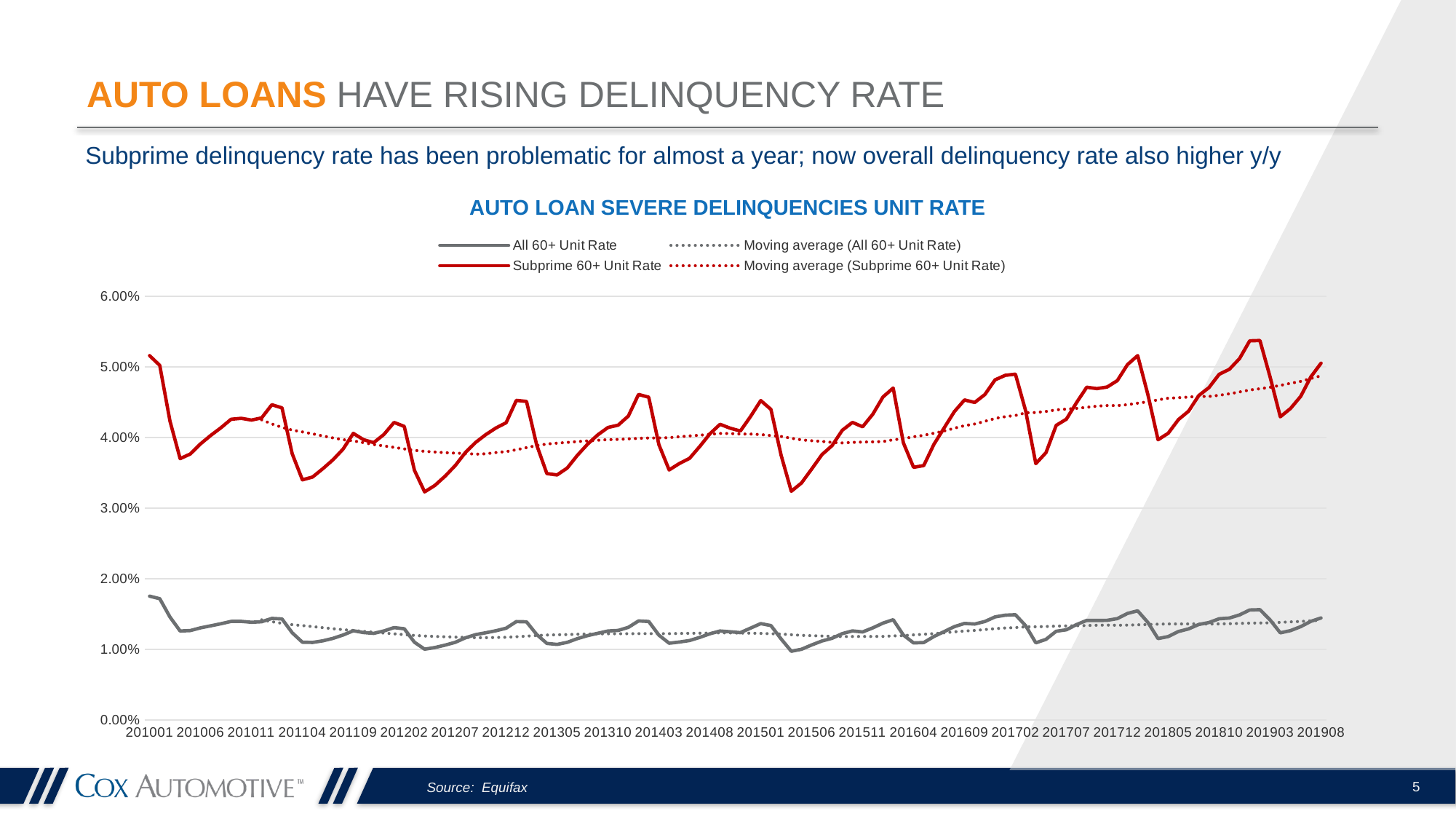
Does the Moving average (Subprime 60+ Unit Rate) rise or fall from 201604 to 201908? rise How many series does the chart's legend list? 4 What source is cited for the chart data? Equifax Is the value of the Subprime 60+ Unit Rate at 201506 greater or less than 4.00%? less Which series reaches the highest value on the chart, All 60+ Unit Rate or Subprime 60+ Unit Rate? Subprime 60+ Unit Rate Is the value of the All 60+ Unit Rate at 201001 greater or less than 2.00%? less What is the title of the chart? AUTO LOAN SEVERE DELINQUENCIES UNIT RATE Does the All 60+ Unit Rate line ever rise above 2.00%? No Which series is higher at every point on the chart, All 60+ Unit Rate or Subprime 60+ Unit Rate? Subprime 60+ Unit Rate What kind of chart is shown on the slide? line chart